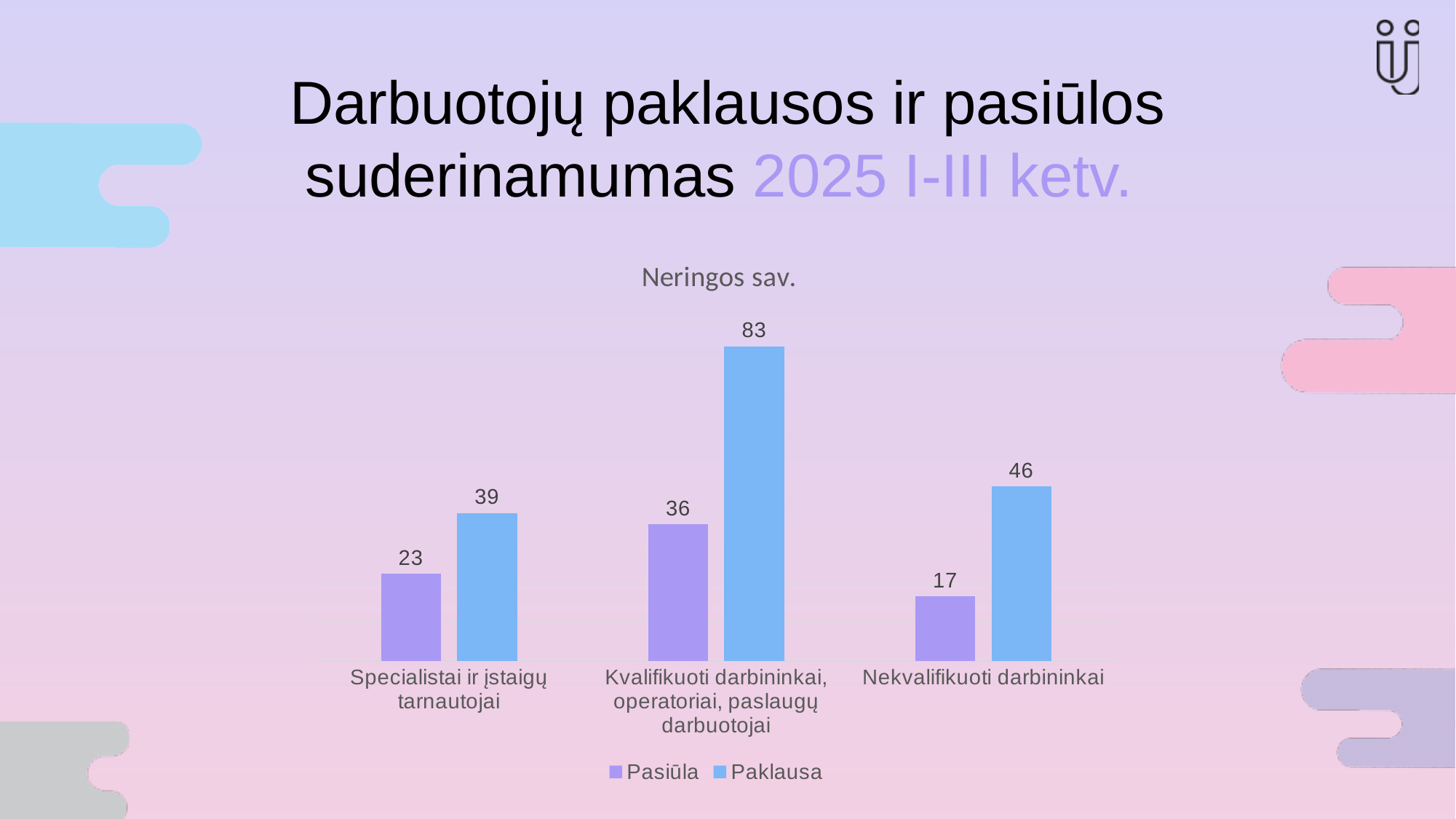
What is the Pasiūla value for Nekvalifikuoti darbininkai? 17 What is the difference between Paklausa and Pasiūla for Specialistai ir įstaigų tarnautojai? 16 Which category has the highest Paklausa value? Kvalifikuoti darbininkai, operatoriai, paslaugų darbuotojai Which is larger for Nekvalifikuoti darbininkai, Pasiūla or Paklausa? Paklausa Which category has the lowest Pasiūla value? Nekvalifikuoti darbininkai What is the title of the chart? Neringos sav. What is the difference between Paklausa and Pasiūla for Kvalifikuoti darbininkai, operatoriai, paslaugų darbuotojai? 47 What is the Pasiūla value for Specialistai ir įstaigų tarnautojai? 23 How many categories are shown on the x axis? 3 What is the Paklausa value for Nekvalifikuoti darbininkai? 46 How many series does the legend list? 2 What is the Paklausa value for Kvalifikuoti darbininkai, operatoriai, paslaugų darbuotojai? 83